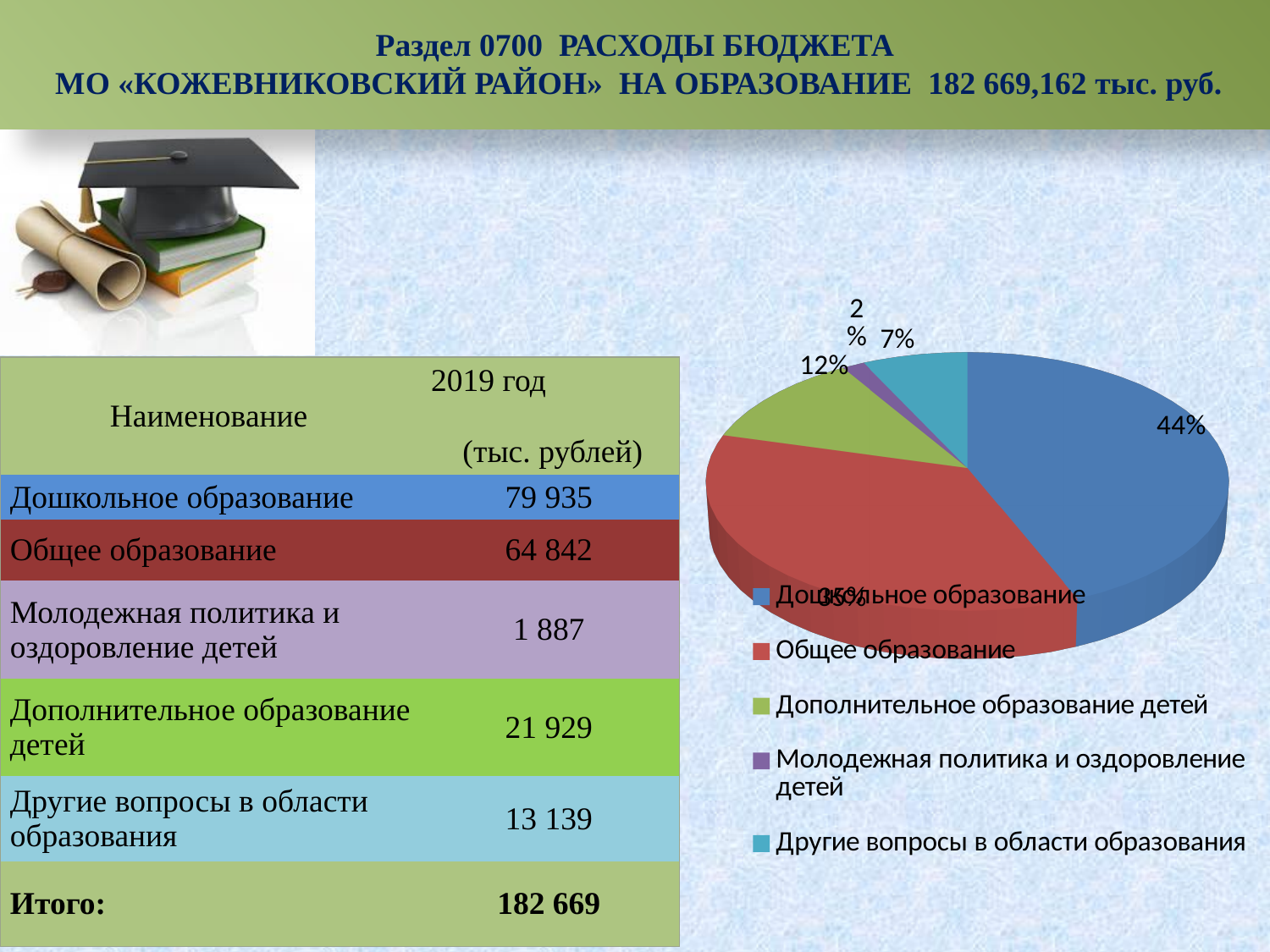
What share of the pie chart does Дошкольное образование have? 44% Which category has the smallest slice in the pie chart? Молодежная политика и оздоровление детей Which category has the largest slice in the pie chart? Дошкольное образование What colour is the Дошкольное образование slice in the pie chart? blue Which slice is larger in the pie chart: Дополнительное образование детей or Другие вопросы в области образования? Дополнительное образование детей By how many percentage points does the Дошкольное образование slice exceed the Дополнительное образование детей slice? 32 percentage points How many categories does the pie chart's legend list? 5 What kind of chart is shown on the slide? pie chart What share of the pie chart does Молодежная политика и оздоровление детей have? 2% By how many percentage points does the Дополнительное образование детей slice exceed the Другие вопросы в области образования slice? 5 percentage points What share of the pie chart does Другие вопросы в области образования have? 7%